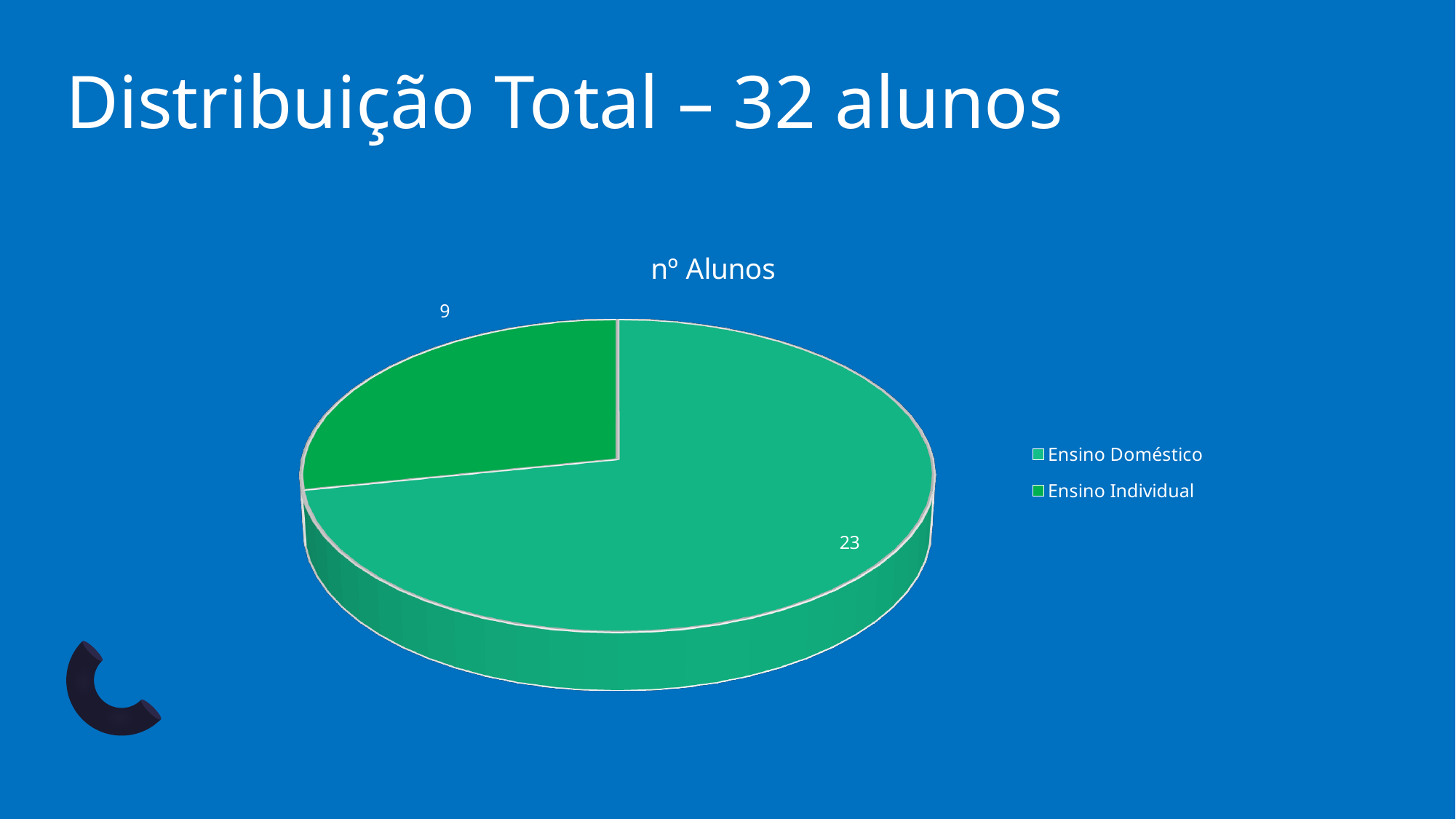
What is the difference between the values for Ensino Doméstico and Ensino Individual? 14 Which category has the smallest slice? Ensino Individual What is the value for Ensino Doméstico? 23 What is the total of all slices in the pie chart? 32 Which is larger, Ensino Doméstico or Ensino Individual? Ensino Doméstico Which category has the largest slice? Ensino Doméstico What is the value for Ensino Individual? 9 What is the title of the chart? nº Alunos How many slices does the pie chart have? 2 What share of the pie does Ensino Individual represent, as a percentage rounded to the nearest whole number? 28% How many entries does the legend list? 2 What kind of chart is shown on the slide? Pie chart